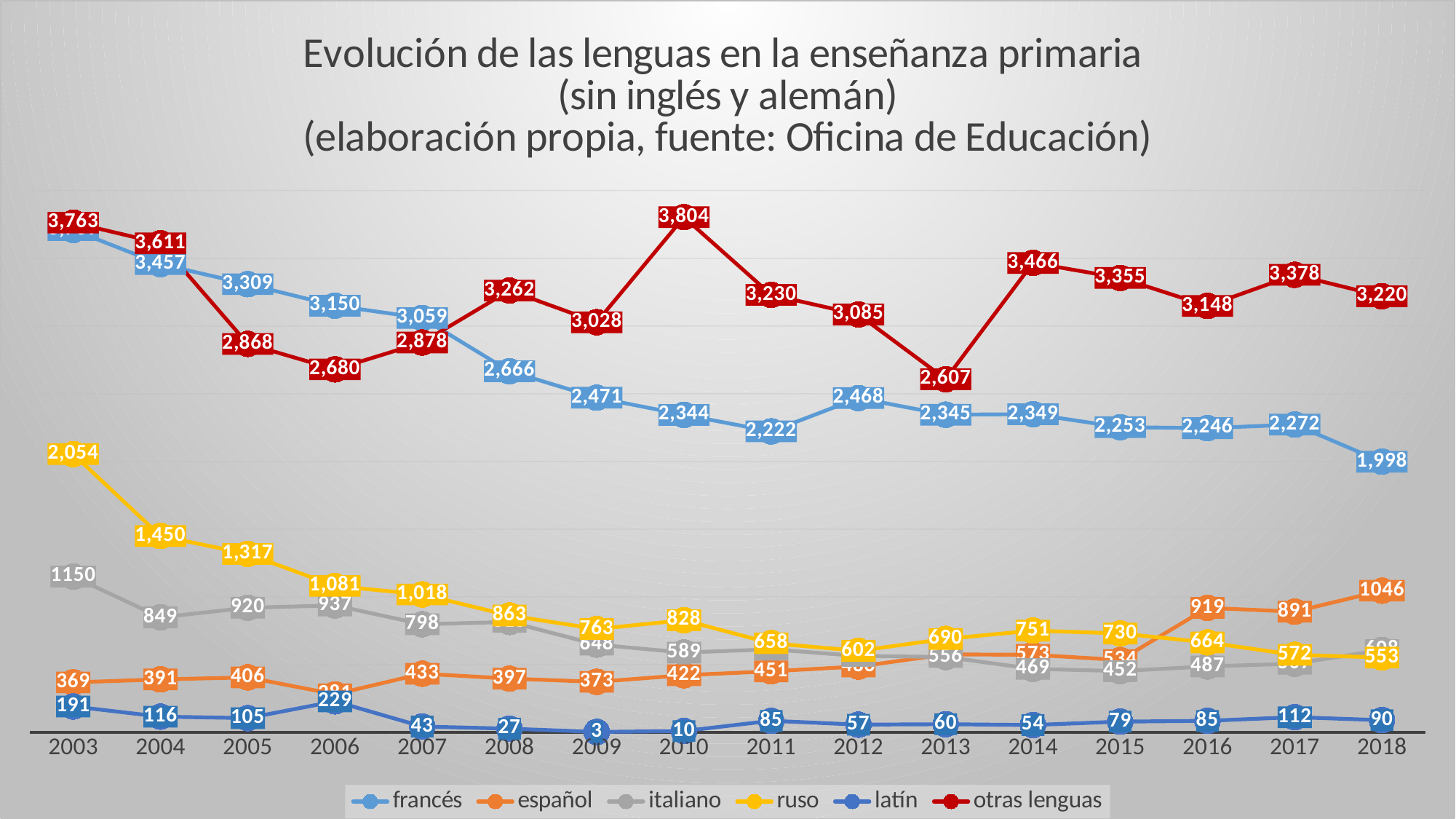
Does the ruso series rise or fall from 2003 to 2007? fall In which year does latín reach its lowest value? 2009 In which year does otras lenguas reach its highest value? 2010 How many series does the legend list? 6 What kind of chart is shown on the slide? line chart What is the value for ruso in 2003? 2,054 What is the difference between the francés value in 2004 and in 2018? 1,459 What is the value for otras lenguas in 2010? 3,804 How many years are shown along the x axis? 16 In which year does otras lenguas reach its lowest value? 2013 What is the value for francés in 2018? 1,998 In 2003, which is larger: ruso or italiano? ruso